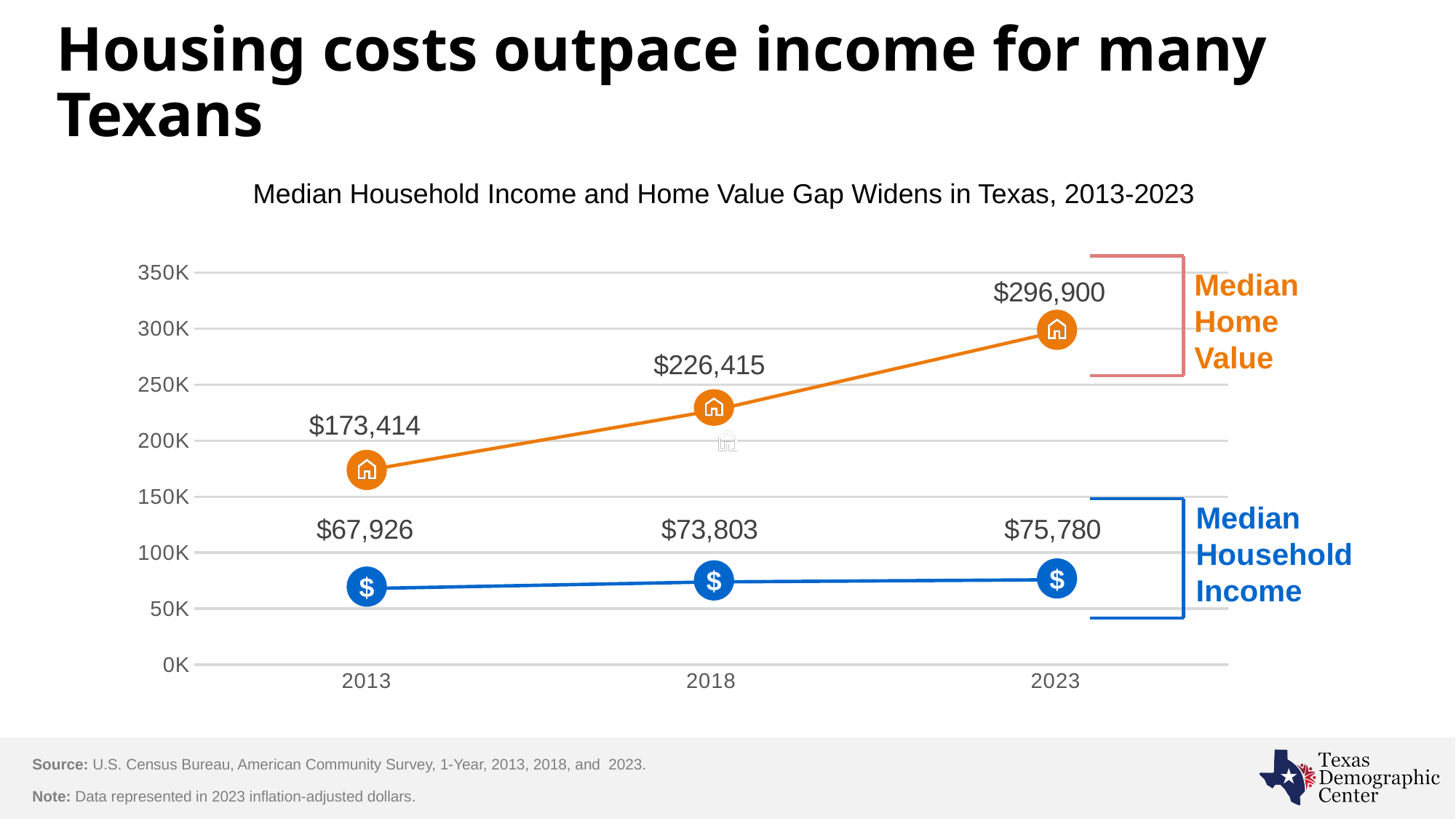
What was the median household income in Texas in 2013? $67,926 How many years are plotted on the x axis? 3 What was the median home value in Texas in 2023? $296,900 What was the median household income in 2023? $75,780 Which is larger: the median household income in 2018 or in 2023? 2023 By how much did the median home value increase from 2013 to 2023? $123,486 What is the difference between the median home value and the median household income in 2023? $221,120 What was the median home value in 2018? $226,415 Does the median home value rise or fall from 2013 to 2023? Rise In which year was the median household income lowest? 2013 In which year was the median home value highest? 2023 What kind of chart is shown on the slide? Line chart